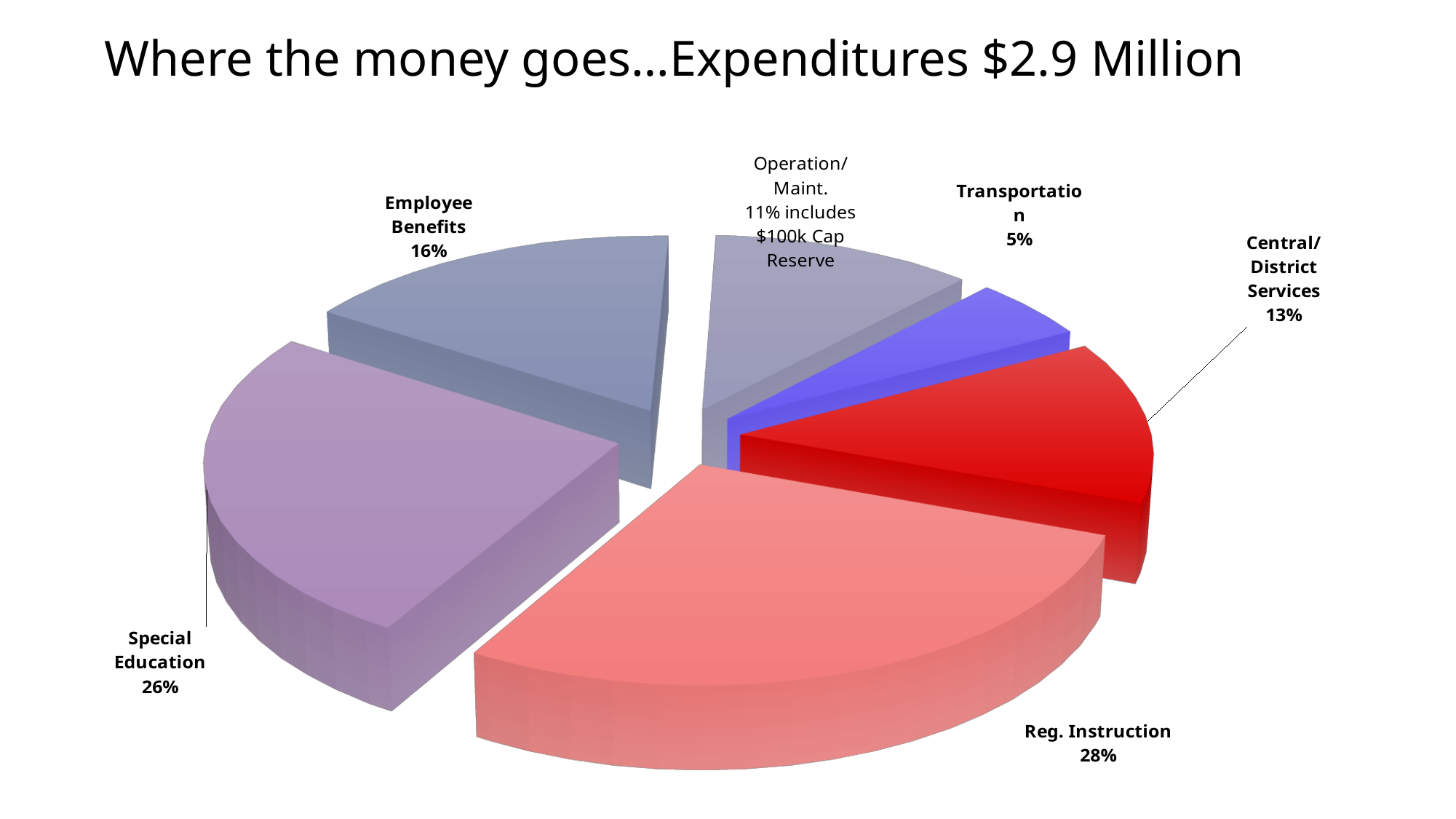
What percentage of expenditures goes to Reg. Instruction? 28% What percentage of expenditures goes to Employee Benefits? 16% What percentage of expenditures goes to Operation/Maint.? 11% How many percentage points larger is the Special Education share than the Employee Benefits share? 10 What percentage of expenditures goes to Transportation? 5% What percentage of expenditures goes to Special Education? 26% What percentage of expenditures goes to Central/District Services? 13% What type of chart is shown on the slide? Pie chart How many categories are shown in the pie chart? 6 Which category receives the smallest share of expenditures? Transportation Which is larger, the share for Central/District Services or the share for Transportation? Central/District Services Which category receives the largest share of expenditures? Reg. Instruction